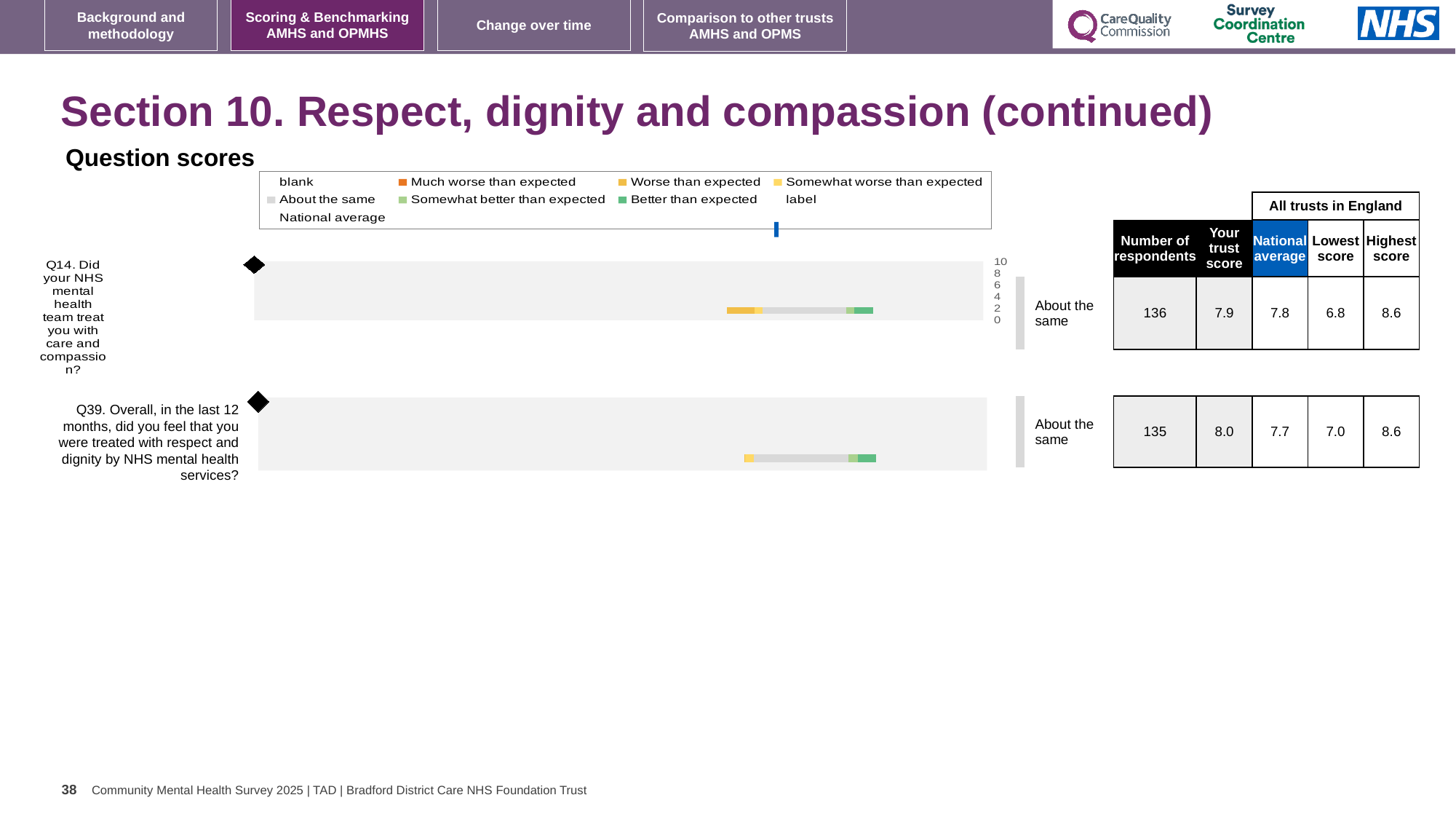
What is the lowest score among all trusts in England for Q39? 7.0 What is the national average score for Q39? 7.7 What is the difference between the highest and lowest scores for Q39 across all trusts in England? 1.6 How many questions are plotted in the Question scores charts on this slide? 2 What is the trust score for Q14 (Did your NHS mental health team treat you with care and compassion?)? 7.9 What is the national average score for Q14? 7.8 What is the trust score for Q39 (treated with respect and dignity by NHS mental health services)? 8.0 How many respondents answered Q14? 136 Which question has the higher trust score, Q14 or Q39? Q39 By how much does the trust score for Q39 exceed the national average for Q39? 0.3 What benchmark category is shown for Q14? About the same What is the highest score among all trusts in England for Q14? 8.6